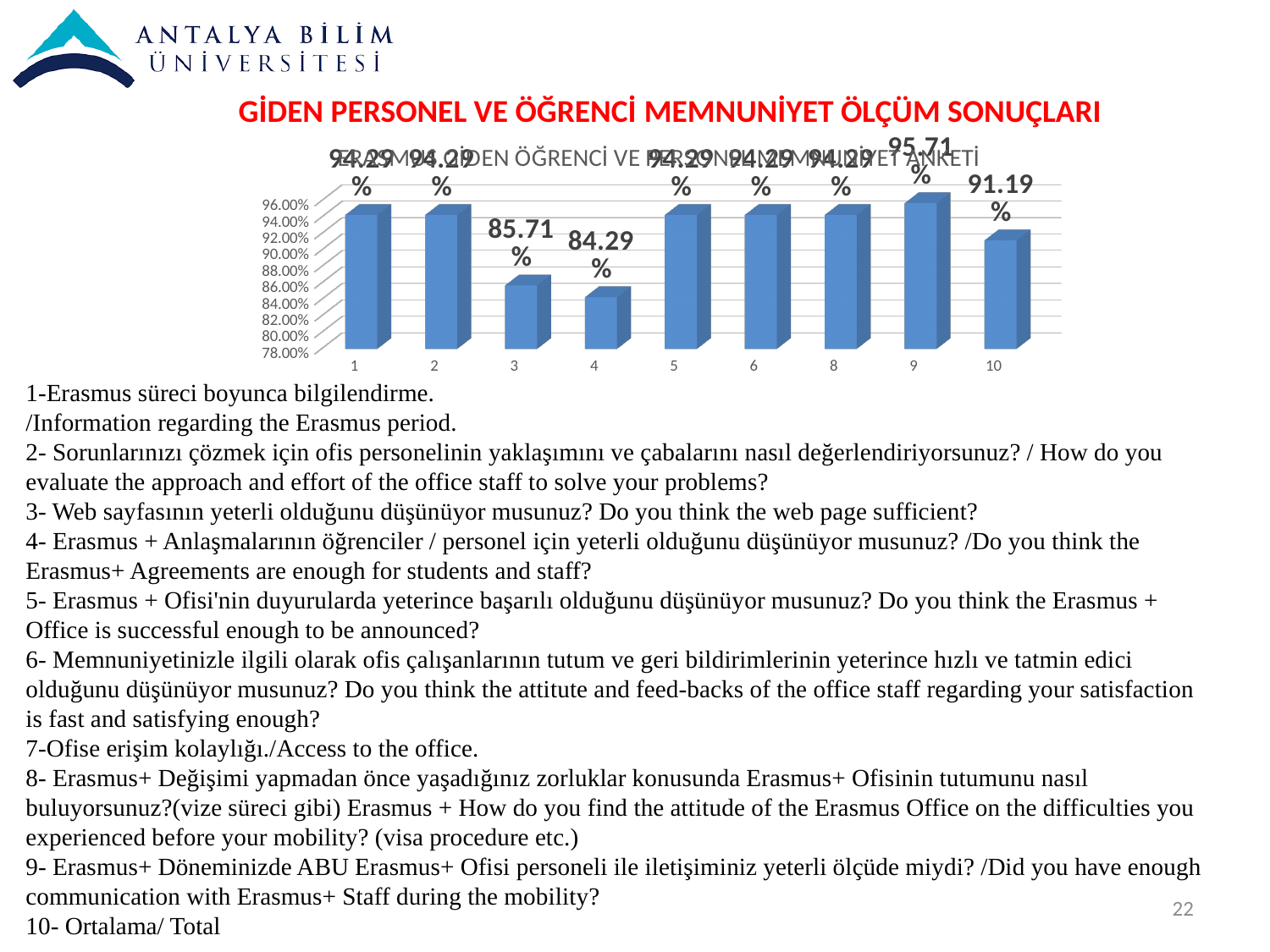
What is the difference between the values for category 9 and category 4? 11.42 percentage points What is the value for category 3? 85.71% Which category has the highest value? 9 What is the value for category 9? 95.71% What kind of chart is shown on the slide? Bar chart Is the value for category 4 greater or less than 86.00%? less What is the difference between the values for category 9 and category 10? 4.52 percentage points Which is larger, the value for category 3 or the value for category 10? Category 10 What is the value for category 10? 91.19% What is the value for category 4? 84.29% Which category has the lowest value? 4 How many bars are plotted in the chart? 9